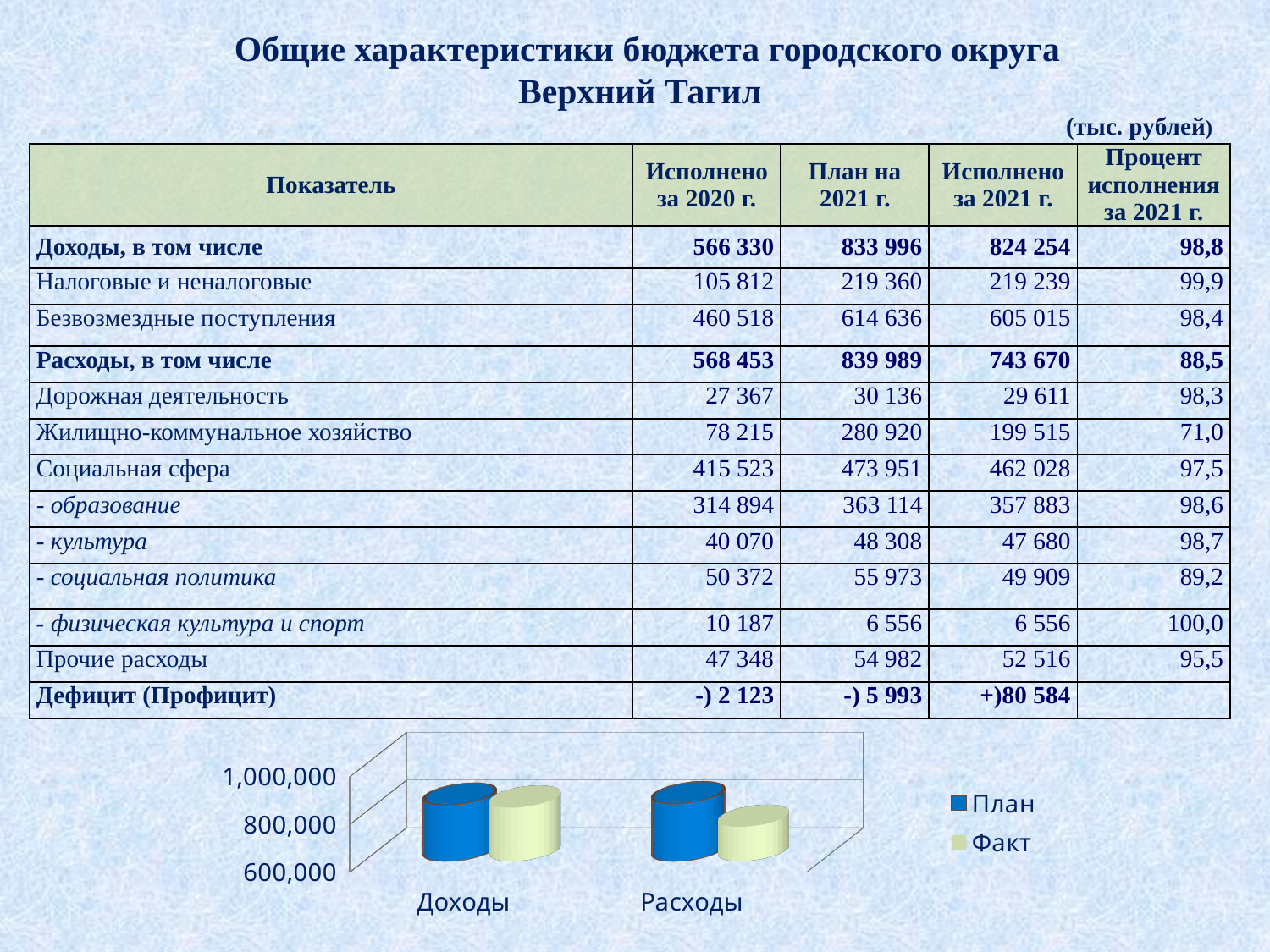
Is the Факт value for Расходы greater or less than 600,000? greater What are the two series named in the chart legend? План and Факт For Расходы, which is larger in the chart: План or Факт? План Which colour represents the План series in the chart? blue Which category has the larger Факт value in the chart: Доходы or Расходы? Доходы How many series does the chart legend list? 2 Is the Факт value for Расходы greater or less than 800,000? less How many categories are shown on the x axis of the chart? 2 Is the План value for Расходы greater or less than 800,000? greater Which category has the lowest Факт bar in the chart? Расходы What kind of chart is shown at the bottom of the slide? bar chart